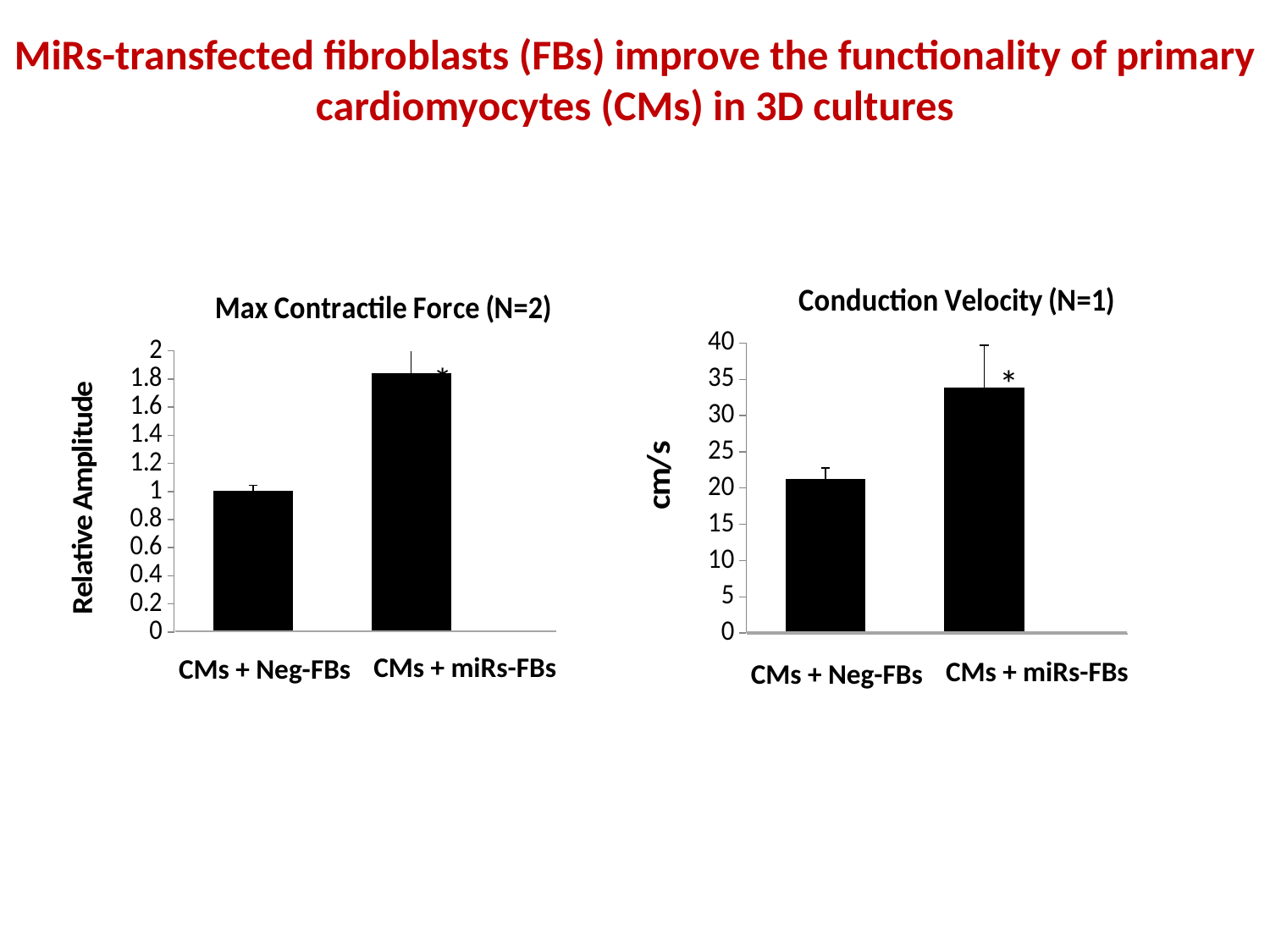
In the Conduction Velocity (N=1) chart, which is larger, CMs + Neg-FBs or CMs + miRs-FBs? CMs + miRs-FBs How many charts are shown on the slide? 2 In the Conduction Velocity (N=1) chart, which category has the lowest conduction velocity? CMs + Neg-FBs In the Conduction Velocity (N=1) chart, is the value for CMs + miRs-FBs greater or less than 30? greater What is the y-axis label of the Conduction Velocity (N=1) chart? cm/s What is the y-axis label of the Max Contractile Force (N=2) chart? Relative Amplitude In the Max Contractile Force (N=2) chart, what is the relative amplitude for CMs + Neg-FBs? 1 In the Max Contractile Force (N=2) chart, is the value for CMs + miRs-FBs greater or less than 1.6? greater What kind of chart is the Conduction Velocity (N=1) chart? Bar chart In the Max Contractile Force (N=2) chart, which category has the higher relative amplitude? CMs + miRs-FBs How many categories are shown in the Max Contractile Force (N=2) chart? 2 In the Conduction Velocity (N=1) chart, is the value for CMs + Neg-FBs greater or less than 25? less